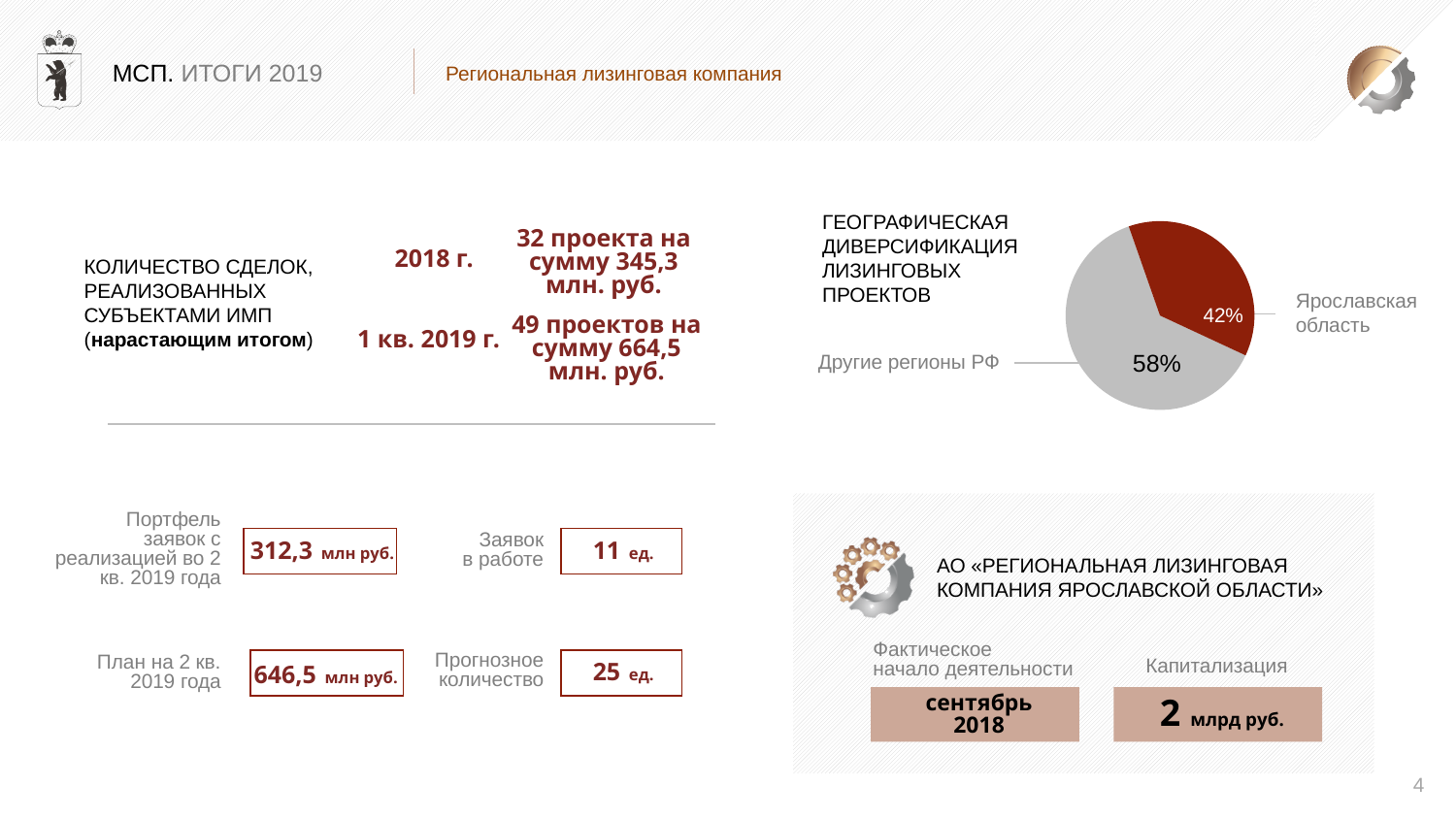
Which slice of the pie chart is the largest? Другие регионы РФ What share of the pie chart does Ярославская область account for? 42% What is the title of the pie chart? ГЕОГРАФИЧЕСКАЯ ДИВЕРСИФИКАЦИЯ ЛИЗИНГОВЫХ ПРОЕКТОВ Is the share for Ярославская область in the pie chart greater or less than 50%? less What do the two slices of the pie chart add up to? 100% What type of chart is shown on the slide? Pie chart How many slices does the pie chart have? 2 Which is larger in the pie chart: Ярославская область or Другие регионы РФ? Другие регионы РФ What is the difference in percentage points between the Другие регионы РФ slice and the Ярославская область slice? 16 What share of the pie chart does Другие регионы РФ account for? 58% Which slice of the pie chart is coloured dark red? Ярославская область Which slice of the pie chart is the smallest? Ярославская область